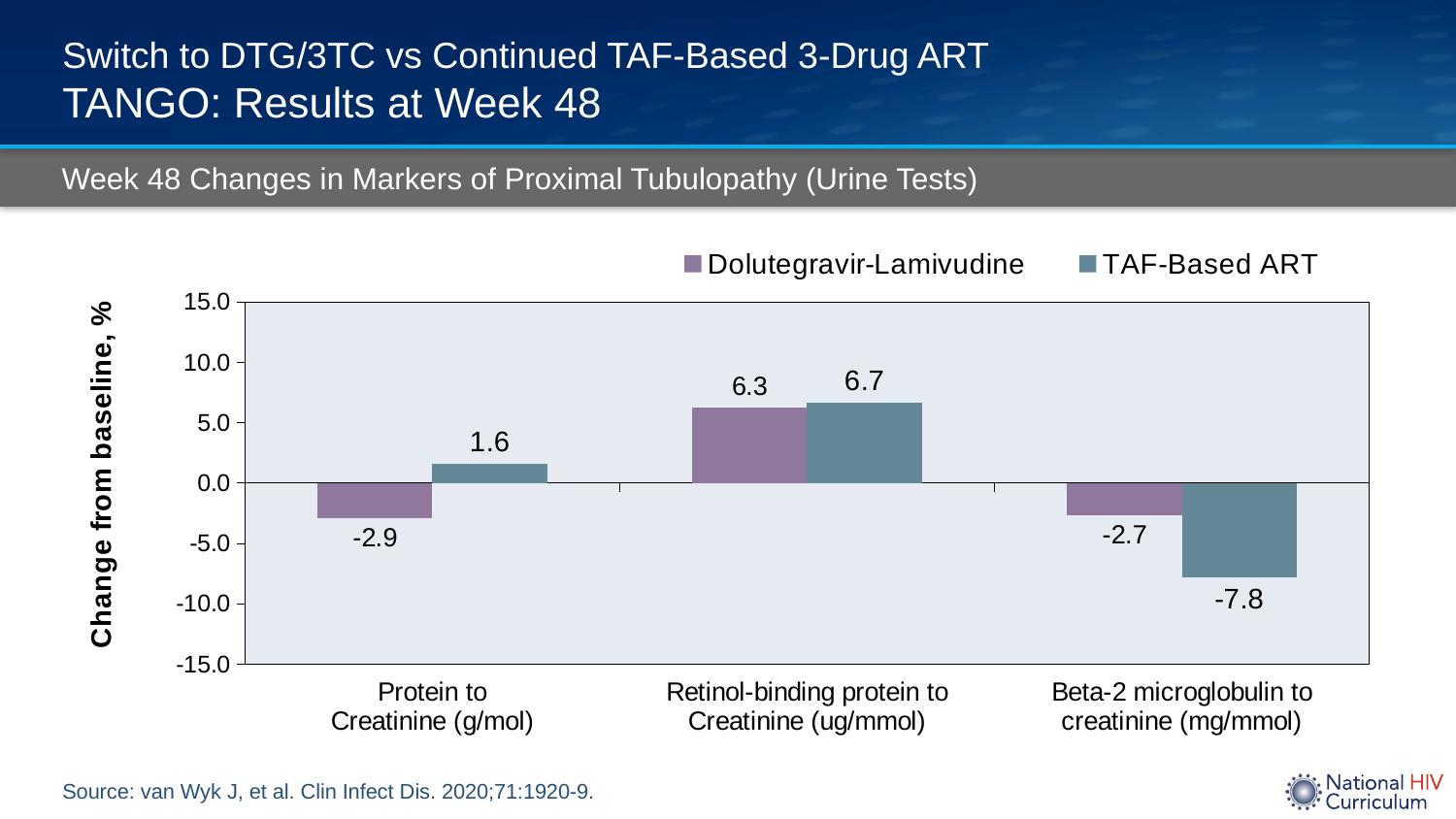
Which category has the lowest value for TAF-Based ART? Beta-2 microglobulin to creatinine (mg/mmol) What is the change from baseline for Dolutegravir-Lamivudine in Retinol-binding protein to Creatinine (ug/mmol)? 6.3 How many series does the legend list? 2 For Beta-2 microglobulin to creatinine (mg/mmol), which series has the larger value, Dolutegravir-Lamivudine or TAF-Based ART? Dolutegravir-Lamivudine What is the change from baseline for TAF-Based ART in Beta-2 microglobulin to creatinine (mg/mmol)? -7.8 What is the change from baseline for Dolutegravir-Lamivudine in Protein to Creatinine (g/mol)? -2.9 What is the change from baseline for Dolutegravir-Lamivudine in Beta-2 microglobulin to creatinine (mg/mmol)? -2.7 Which category has the highest value for TAF-Based ART? Retinol-binding protein to Creatinine (ug/mmol) What kind of chart is shown on the slide? Bar chart How many categories are shown on the x axis? 3 What is the difference between the TAF-Based ART and Dolutegravir-Lamivudine values for Protein to Creatinine (g/mol)? 4.5 What is the change from baseline for TAF-Based ART in Protein to Creatinine (g/mol)? 1.6